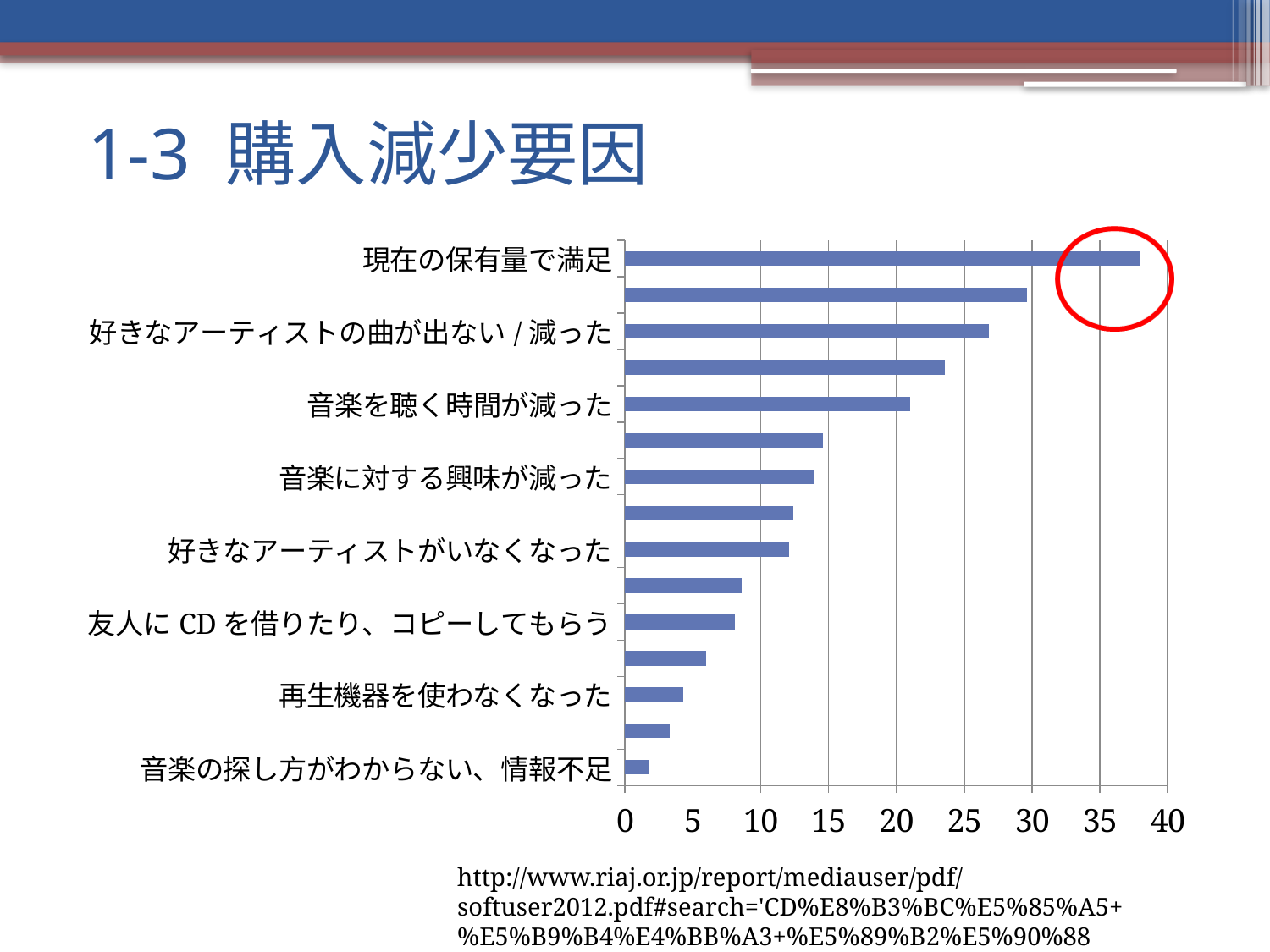
Is the value for 友人に CD を借りたり、コピーしてもらう greater or less than 10? less Which category has the highest value in the chart? 現在の保有量で満足 Which category has the lowest value in the chart? 音楽の探し方がわからない、情報不足 Is the value for 現在の保有量で満足 greater or less than 35? greater Is the value for 好きなアーティストの曲が出ない / 減った greater or less than 25? greater How many bars are plotted in the chart? 15 Do the bar values increase or decrease going from the top of the chart to the bottom? decrease Which bar is highlighted with a red circle on the slide? 現在の保有量で満足 What kind of chart is shown on the slide? bar chart Which is larger, the value for 音楽を聴く時間が減った or the value for 好きなアーティストがいなくなった? 音楽を聴く時間が減った